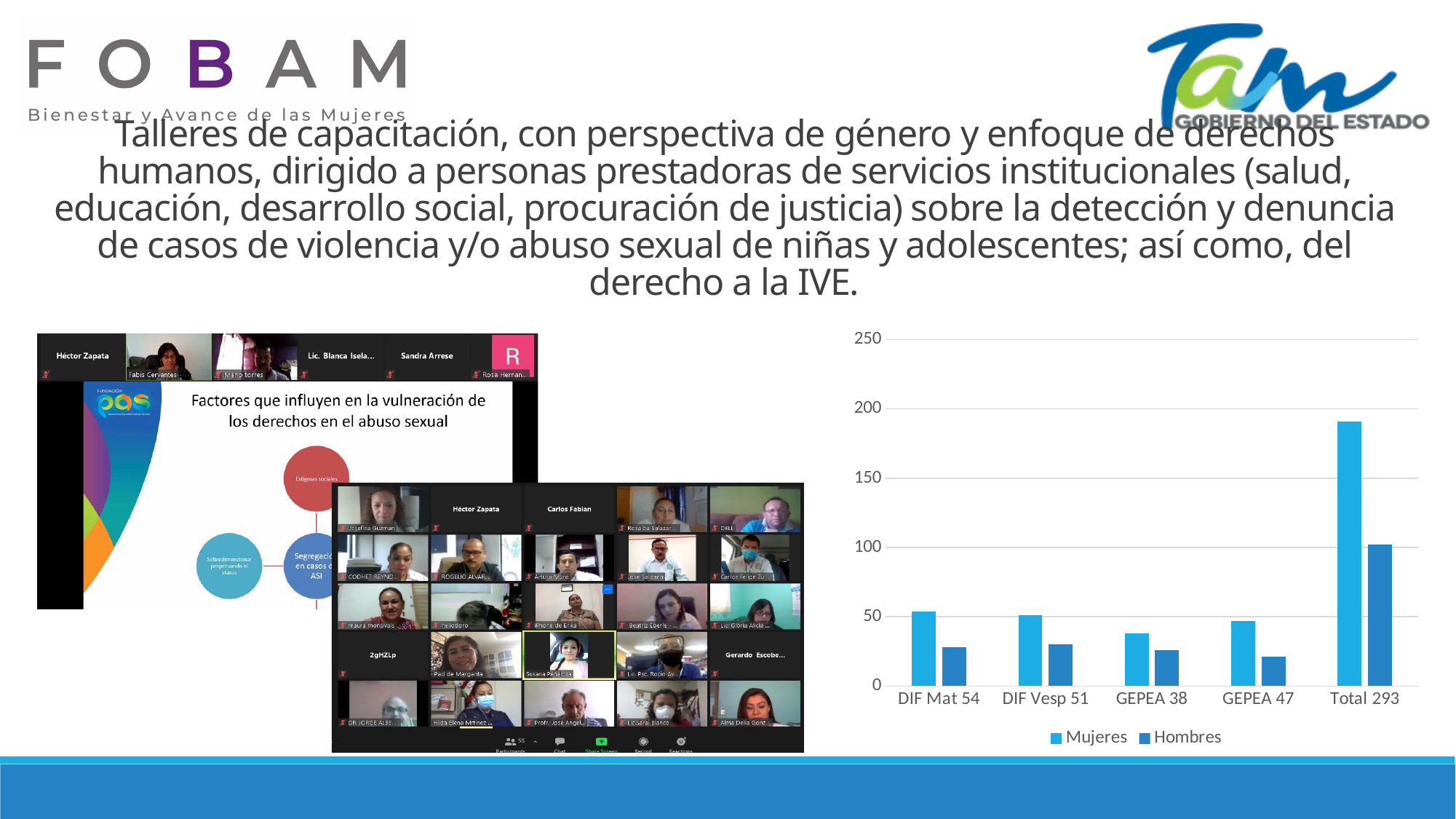
What kind of chart is shown on the slide? bar chart Which category has the lowest Mujeres bar? GEPEA 38 Which category has the highest Mujeres bar? Total 293 How many series does the chart's legend list? 2 What are the two series named in the chart's legend? Mujeres and Hombres Is the Mujeres value for Total 293 greater or less than 150? greater How many categories are shown on the x axis of the chart? 5 Is the Mujeres value for Total 293 greater or less than 200? less Which is larger, the Mujeres bar for DIF Mat 54 or the Mujeres bar for GEPEA 38? DIF Mat 54 In the Total 293 category, which is larger, Mujeres or Hombres? Mujeres Is the Mujeres value for GEPEA 38 greater or less than 50? less